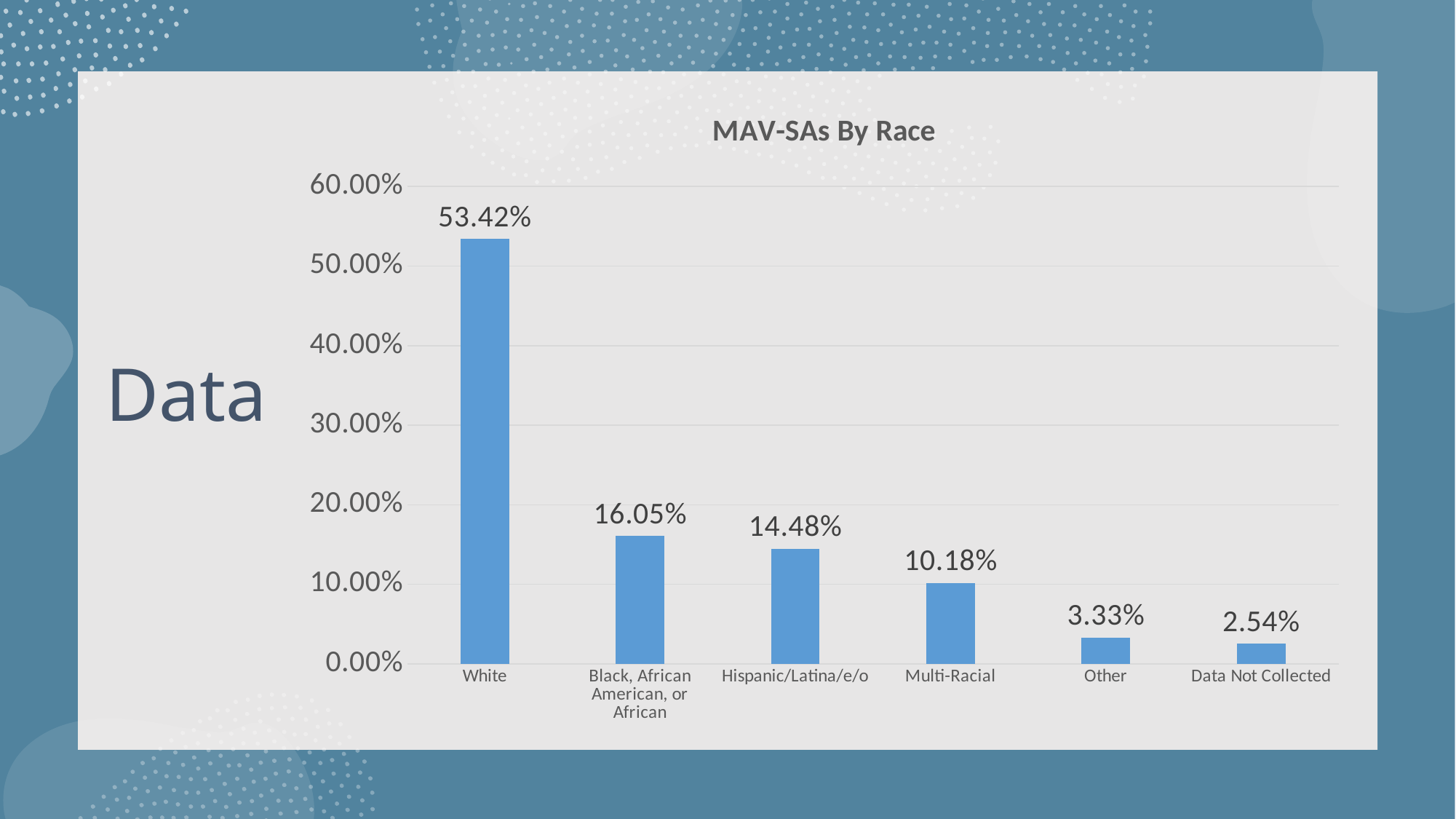
Is the value for Multi-Racial greater or less than 20.00%? less What kind of chart is this? bar chart What is the value for Data Not Collected? 2.54% What is the value for Black, African American, or African? 16.05% What is the value for White? 53.42% Which category has the lowest value? Data Not Collected How many categories are shown on the x axis? 6 What is the value for Hispanic/Latina/e/o? 14.48% What is the difference between the values for White and Black, African American, or African? 37.37% Which category has the highest value? White Which is larger, the value for Other or the value for Data Not Collected? Other What is the value for Multi-Racial? 10.18%